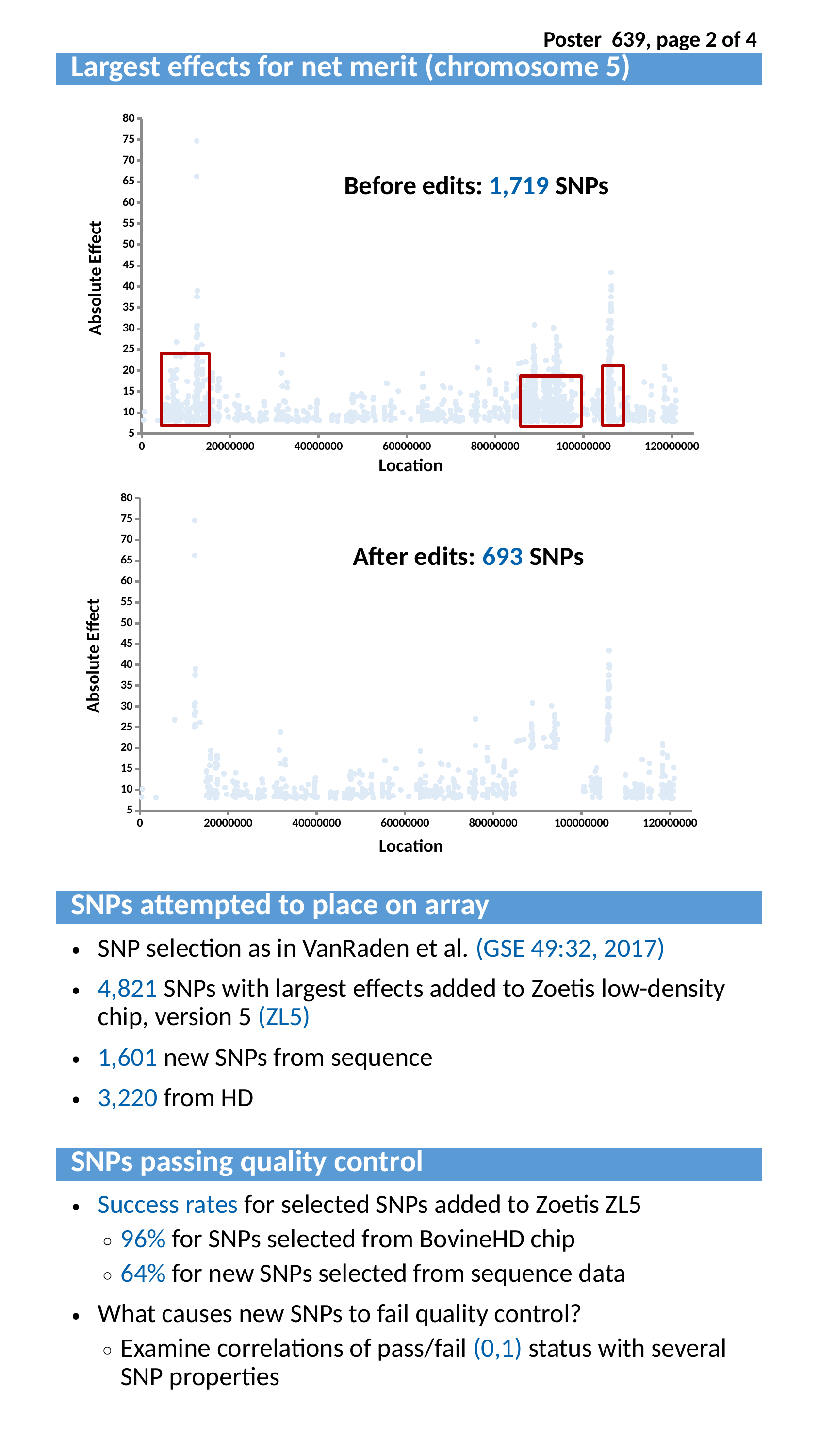
What is the maximum value shown on the x-axis of the bottom chart? 120000000 Which chart shows more SNPs, the 'Before edits' chart or the 'After edits' chart? Before edits In the top chart, is the highest plotted absolute effect greater or less than 70? greater In the bottom chart, is the highest plotted absolute effect near location 105000000 greater or less than 40? greater What is the label of the x-axis on the bottom chart? Location How many more SNPs are in the 'Before edits' chart than in the 'After edits' chart? 1,026 What is the label of the y-axis on the top chart? Absolute Effect What kind of chart is the bottom chart on the slide? scatter plot What kind of chart is the top chart on the slide? scatter plot In the top chart, how many SNPs are shown before edits according to the annotation? 1,719 SNPs What is the maximum value shown on the y-axis of the top chart? 80 In the bottom chart, how many SNPs are shown after edits according to the annotation? 693 SNPs